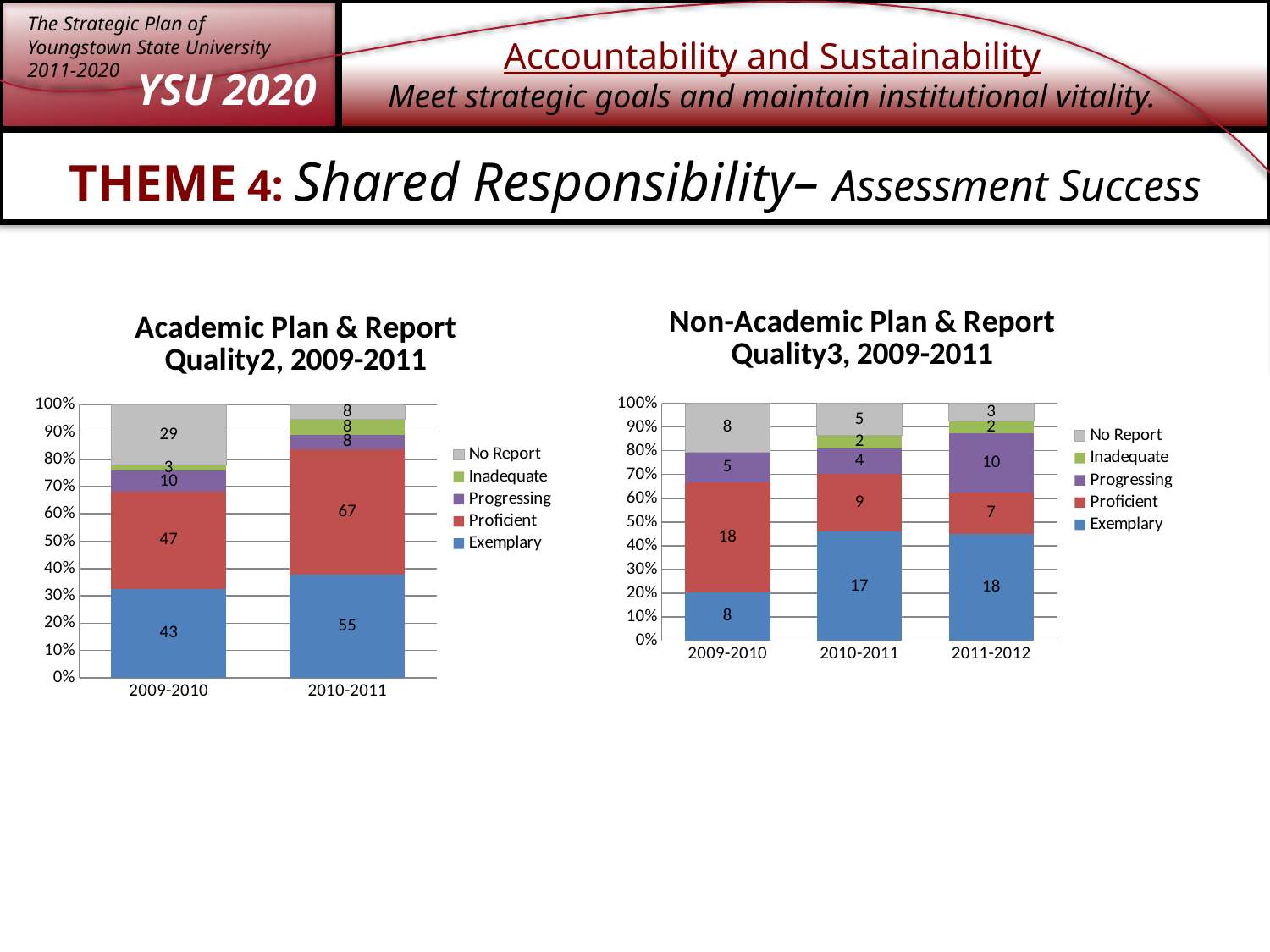
In the Non-Academic Plan & Report Quality3 chart, what is the total of all segments in the 2011-2012 bar? 40 In the Academic Plan & Report Quality2 chart, what is the No Report value for 2009-2010? 29 How many year categories are shown on the x axis of the Non-Academic Plan & Report Quality3 chart? 3 In the Non-Academic Plan & Report Quality3 chart, what is the Exemplary value for 2010-2011? 17 In the Non-Academic Plan & Report Quality3 chart, what is the Progressing value for 2011-2012? 10 How many series does the legend of the Academic Plan & Report Quality2 chart list? 5 In the Academic Plan & Report Quality2 chart, what is the total of all segments in the 2010-2011 bar? 146 In the Non-Academic Plan & Report Quality3 chart, which year has the higher Proficient value, 2009-2010 or 2011-2012? 2009-2010 What type of chart is the Non-Academic Plan & Report Quality3 chart? Stacked bar chart In the Academic Plan & Report Quality2 chart, what is the Proficient value for 2010-2011? 67 In the Academic Plan & Report Quality2 chart, which series is shown in blue? Exemplary In the Academic Plan & Report Quality2 chart, what is the difference between the Exemplary values for 2010-2011 and 2009-2010? 12